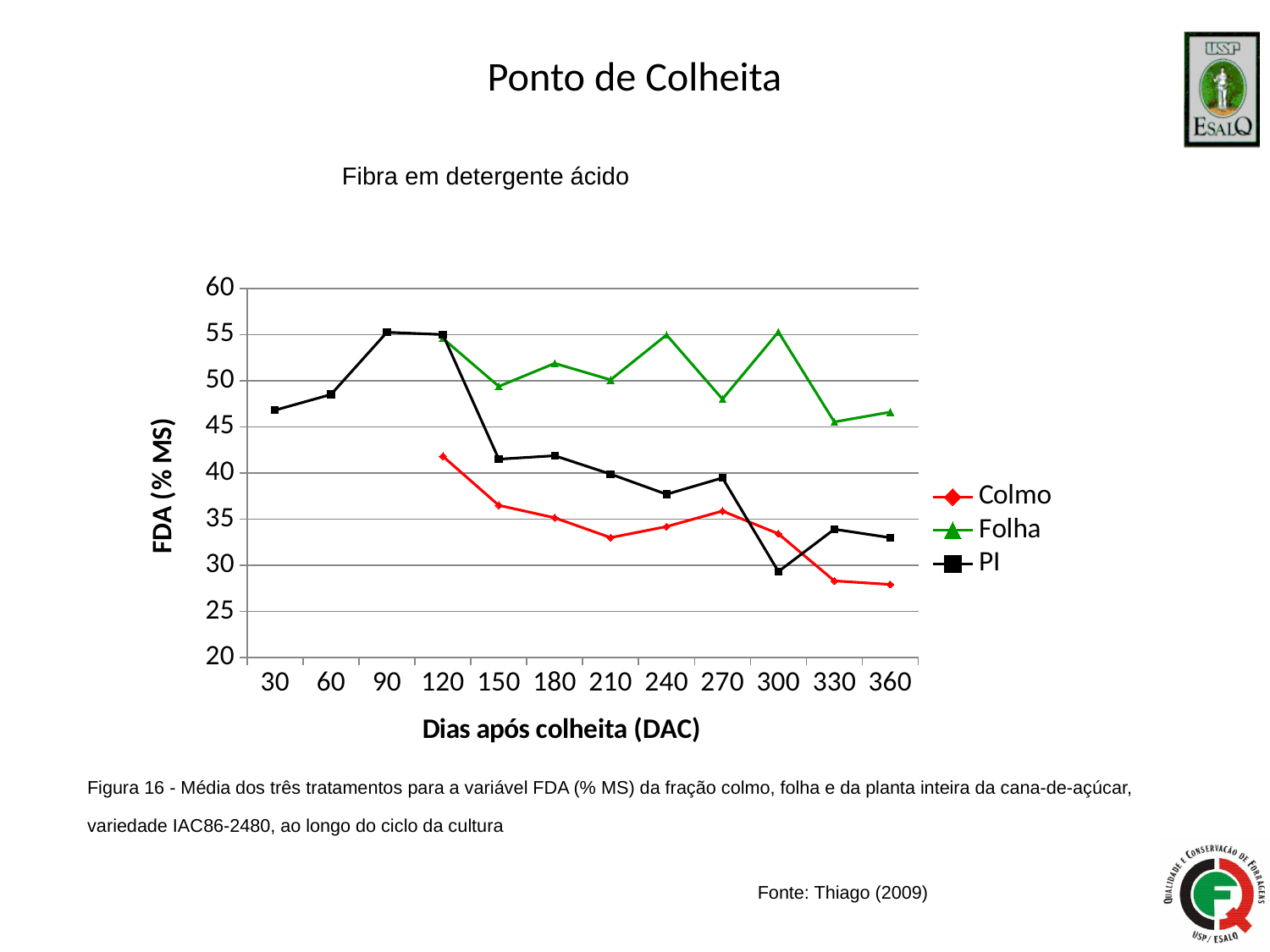
Which series has the highest FDA value at 360 DAC? Folha How many series does the legend list? 3 At which DAC does the PI series reach its lowest value? 300 Is the value for PI at 30 DAC greater or less than 50? less Does the Colmo series overall rise or fall from 120 DAC to 360 DAC? fall What kind of chart is shown on the slide? line chart Which series has the lowest FDA value at 360 DAC? Colmo At which DAC does the Colmo series reach its highest value? 120 Is the value for PI at 240 DAC greater or less than 40? less Is the value for Colmo at 360 DAC greater or less than 30? less How many points (DAC values) are shown along the x axis? 12 At 300 DAC, which is larger: the value for Colmo or the value for PI? Colmo